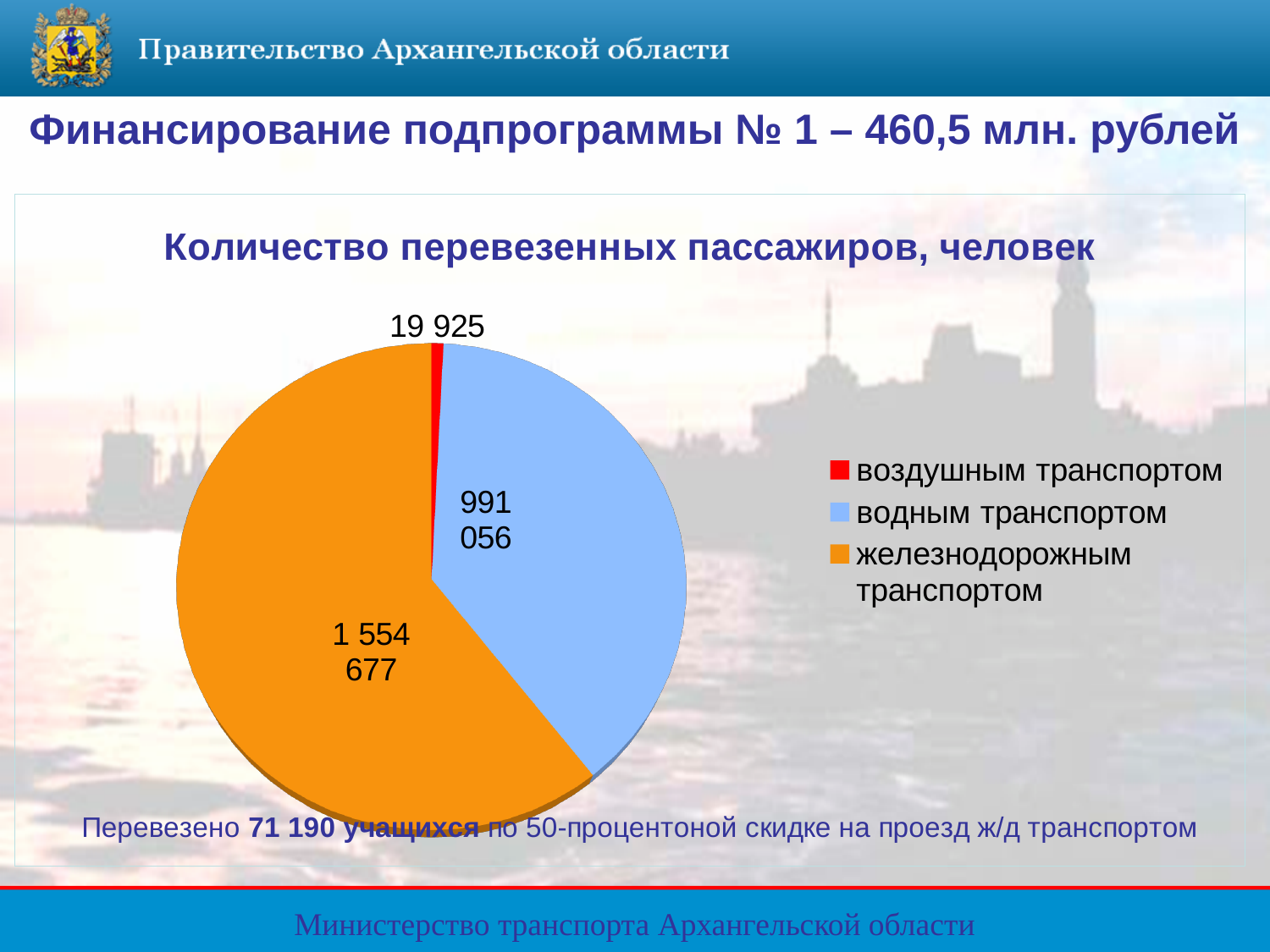
Which mode of transport carried the most passengers? железнодорожным транспортом How many passengers were carried by air transport (воздушным транспортом)? 19 925 What is the difference between the number of passengers carried by rail and by water transport? 563 621 How many passengers were carried by water transport (водным транспортом)? 991 056 How many entries does the legend list? 3 How many slices does the pie chart have? 3 What type of chart is shown on the slide? Pie chart Which mode of transport carried the fewest passengers? воздушным транспортом What is the chart's title? Количество перевезенных пассажиров, человек Which carried more passengers: water transport or air transport? водным транспортом Which colour represents rail transport (железнодорожным транспортом) in the chart? Orange How many passengers were carried by rail transport (железнодорожным транспортом)? 1 554 677